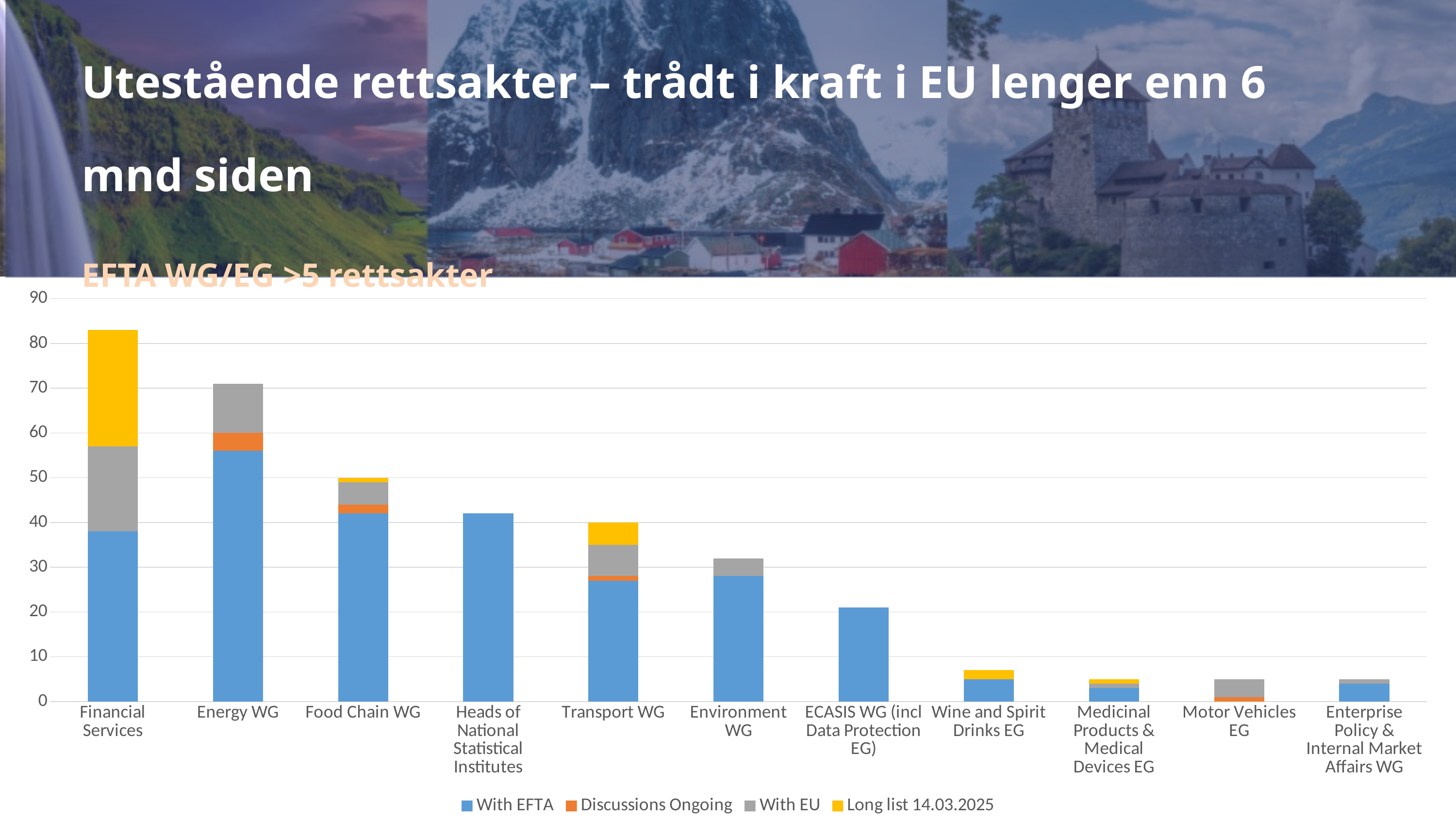
What kind of chart is shown on the slide? bar chart How many categories are shown on the x axis? 11 What are the four legend entries of the chart? With EFTA, Discussions Ongoing, With EU, Long list 14.03.2025 How many series does the legend list? 4 Which has a larger total bar, Energy WG or Food Chain WG? Energy WG Do the total bar heights generally rise or fall from left to right along the x axis? fall Which category has the highest total bar? Financial Services Is the total for Energy WG greater or less than 60? greater Is the total for Heads of National Statistical Institutes greater or less than 50? less Which has a larger total bar, Transport WG or Environment WG? Transport WG Is the total for ECASIS WG (incl Data Protection EG) greater or less than 30? less